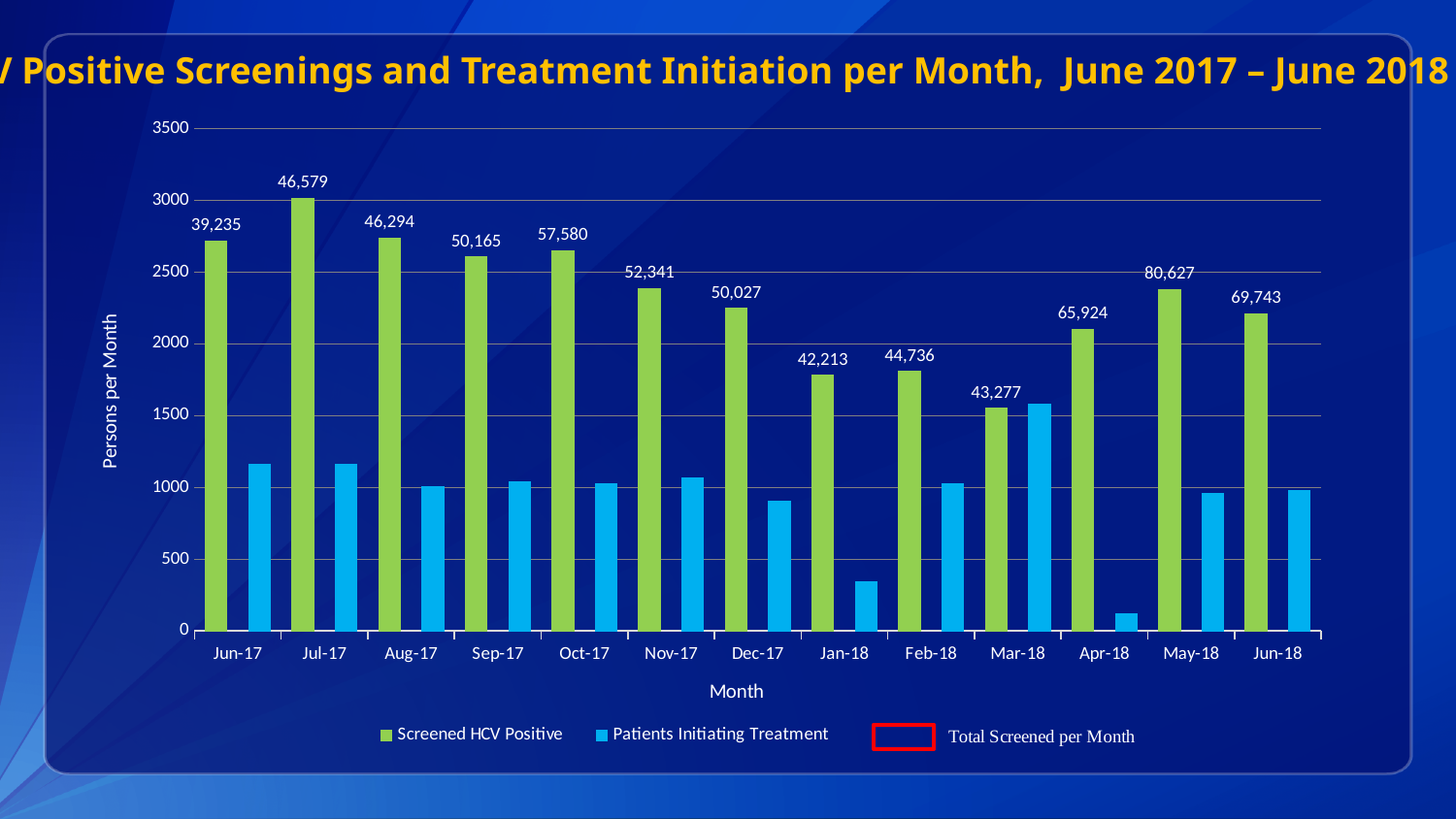
Which month has the highest Patients Initiating Treatment bar? Mar-18 Which month has the highest Screened HCV Positive bar? Jul-17 What is the difference between the Total Screened per Month figures for May-18 and Jun-18? 10,884 Which is larger, the Screened HCV Positive bar for Jun-17 or for Jun-18? Jun-17 Is the Patients Initiating Treatment value for Apr-18 greater or less than 500? less Which month has the lowest Patients Initiating Treatment bar? Apr-18 How many months are shown on the x axis of the chart? 13 What is the Total Screened per Month figure printed for May-18? 80,627 Which month has the lowest Screened HCV Positive bar? Mar-18 What is the Total Screened per Month figure printed for Jun-17? 39,235 Is the Screened HCV Positive value for Jul-17 greater or less than 2500? greater What kind of chart is shown on the slide? bar chart